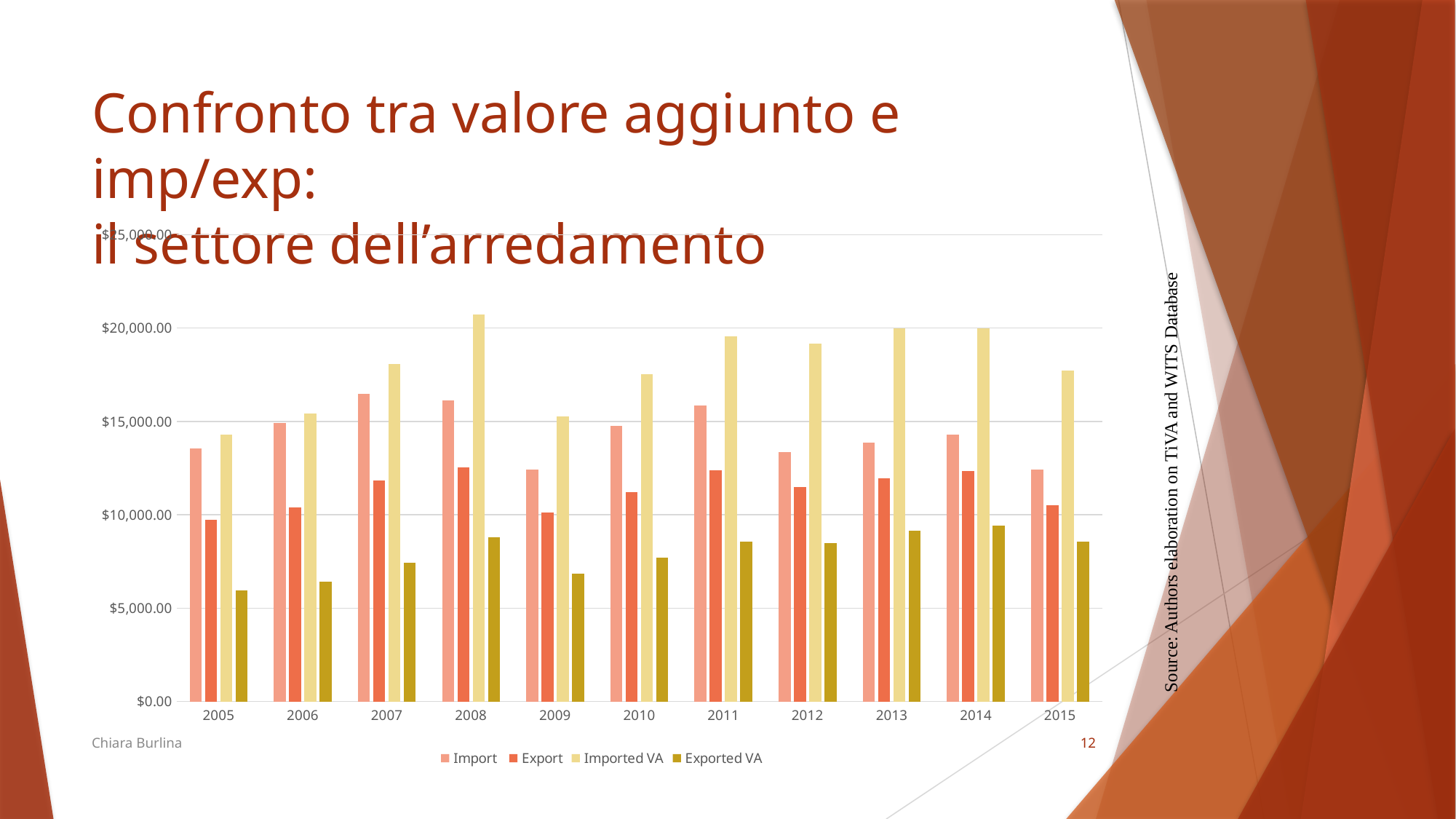
Which is larger: the Exported VA value for 2005 or for 2014? 2014 How many years are shown on the x axis of the chart? 11 Which series are listed in the chart legend? Import, Export, Imported VA, Exported VA Is the Import value for 2007 greater or less than $15,000.00? greater What kind of chart is shown on the slide? bar chart In 2011, which is larger: Import or Imported VA? Imported VA Is the Imported VA value for 2008 greater or less than $20,000.00? greater Does the Exported VA series rise or fall from 2005 to 2008? rise In which year is the Export bar the lowest? 2005 How many series does the chart legend list? 4 In which year is the Imported VA bar the highest? 2008